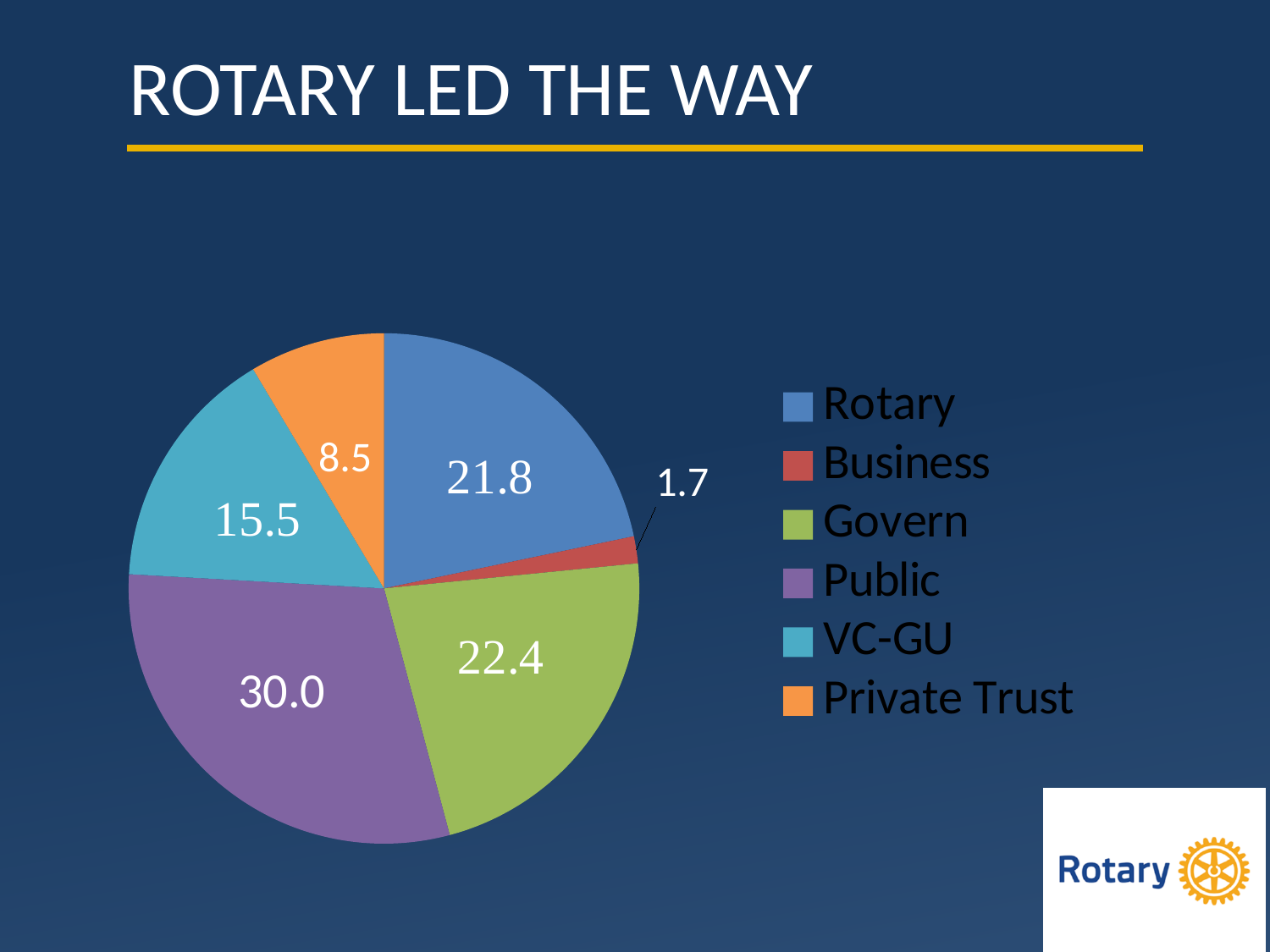
What is the value for Rotary in the pie chart? 21.8 Which colour represents Govern in the pie chart? Green What is the value for VC-GU in the pie chart? 15.5 Which category has the smallest slice of the pie? Business What is the difference between the values for Public and Rotary? 8.2 What is the value for Business in the pie chart? 1.7 Which category has the largest slice of the pie? Public What type of chart is shown on the slide? Pie chart How many categories does the pie chart show? 6 What is the value for Govern in the pie chart? 22.4 Which is larger, the value for Private Trust or the value for VC-GU? VC-GU What is the title of the slide containing the pie chart? ROTARY LED THE WAY